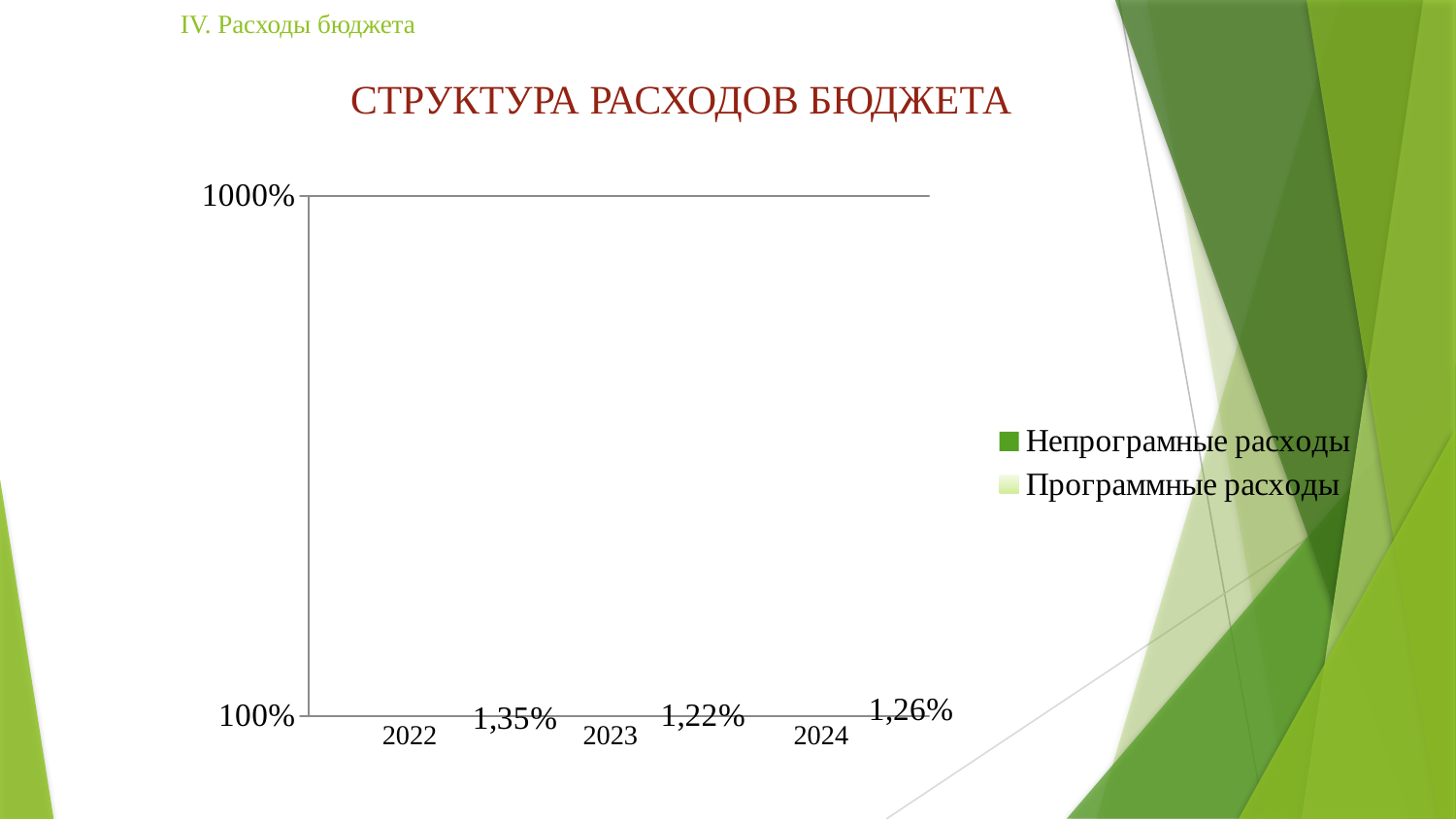
What is the second data label printed along the bottom of the chart, reading left to right? 1,22% What is the third data label printed along the bottom of the chart, reading left to right? 1,26% What are the lowest and highest tick values shown on the vertical axis of the chart? 100% and 1000% Which of the three data labels printed on the chart is the highest value? 1,35% What is the title of the chart? СТРУКТУРА РАСХОДОВ БЮДЖЕТА What is the first data label printed along the bottom of the chart, reading left to right? 1,35% How many series does the chart legend list? 2 How many years are shown on the x axis of the chart? 3 What is the difference between the highest and lowest data labels printed on the chart (1,35% and 1,22%)? 0,13% Which of the three data labels printed on the chart is the lowest value? 1,22% What are the two entries in the chart legend? Непрограмные расходы, Программные расходы Which years are shown on the x axis of the chart? 2022, 2023, 2024